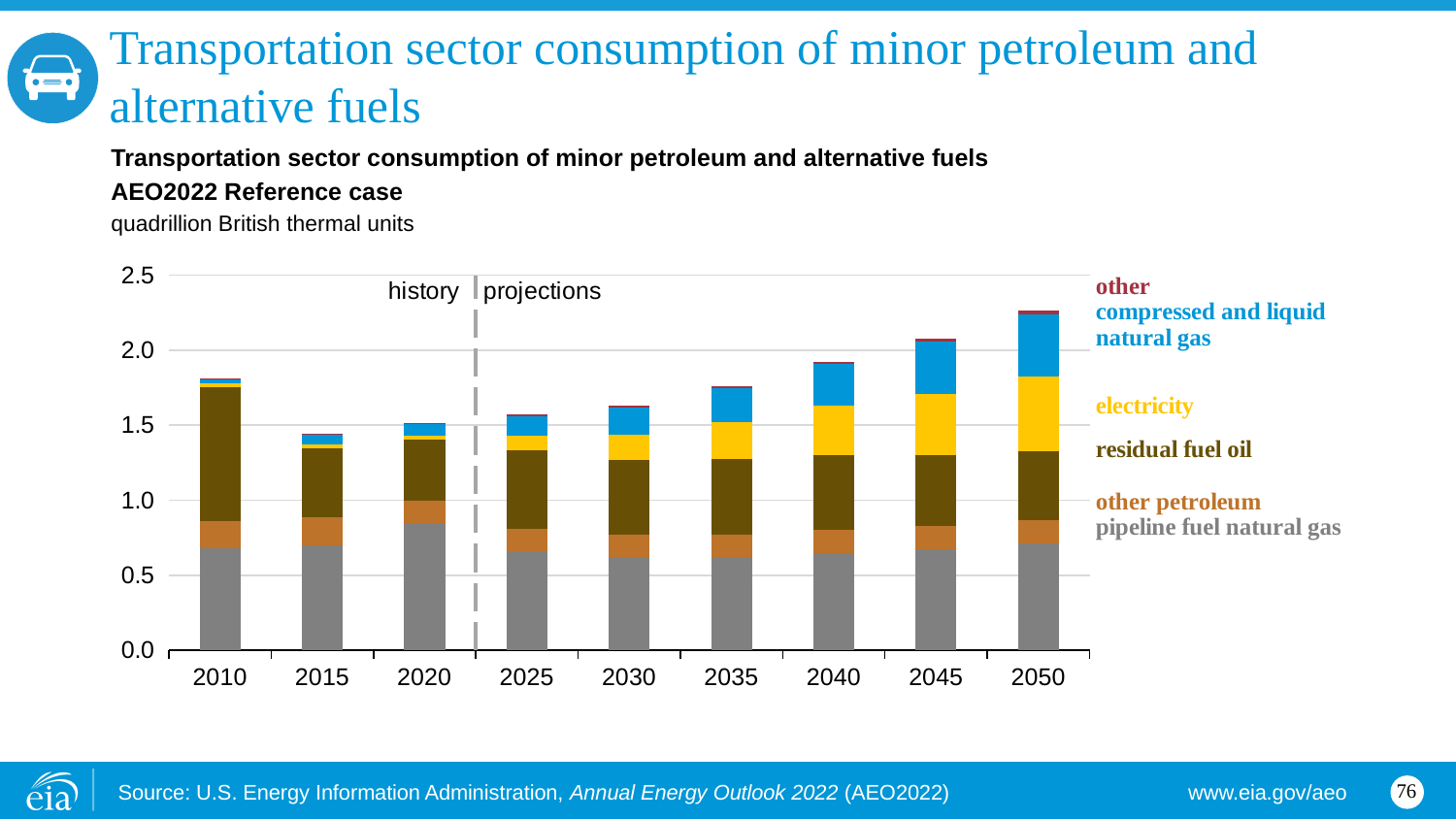
Which year has the lowest total consumption in the chart? 2015 Which year has the larger total consumption, 2010 or 2015? 2010 Is the total consumption for 2040 greater or less than 2.0 quadrillion Btu? less What kind of chart is shown on the slide? stacked bar chart Which year has the highest total consumption in the chart? 2050 What do the two labels on either side of the dashed vertical line in the chart say? history and projections Do total consumption values rise or fall from 2025 to 2050? rise Is the total consumption for 2050 greater or less than 2.0 quadrillion Btu? greater How many years are shown along the x axis of the chart? 9 Is the total consumption for 2015 greater or less than 1.5 quadrillion Btu? less How many fuel series does the chart's legend list? 6 What unit of measurement is used for the chart's values? quadrillion British thermal units